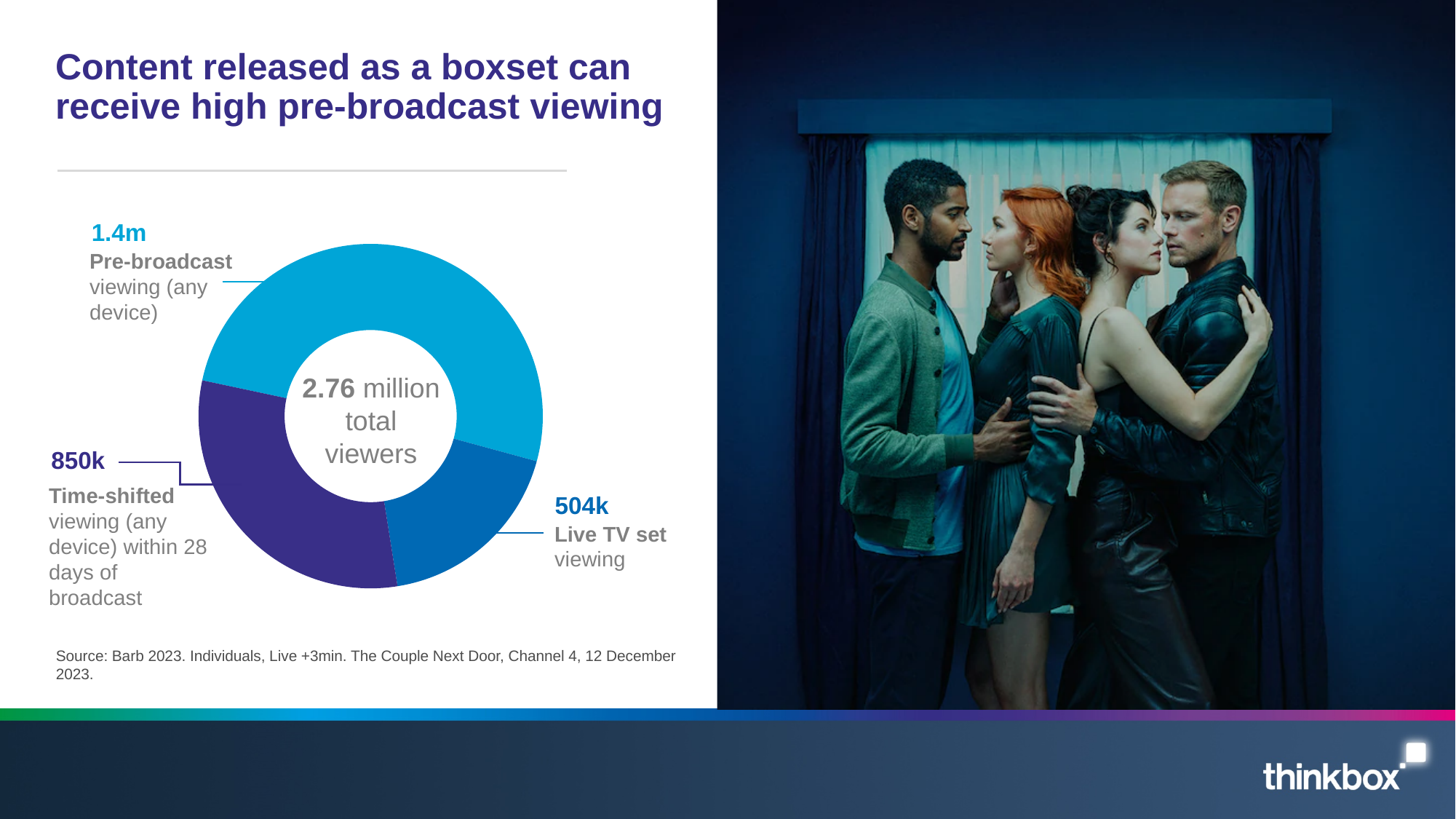
What is the value for Time-shifted viewing (any device) within 28 days of broadcast? 850k Which is larger, Time-shifted viewing or Live TV set viewing? Time-shifted viewing What kind of chart is shown on the slide? Donut chart What is the value for Live TV set viewing? 504k What is the value for Pre-broadcast viewing (any device)? 1.4m What is the total number of viewers shown in the centre of the chart? 2.76 million Which viewing category has the largest segment of the chart? Pre-broadcast viewing (any device) What colour is the Time-shifted viewing segment of the chart? Purple Which viewing category has the smallest segment of the chart? Live TV set viewing What is the title of the slide containing the chart? Content released as a boxset can receive high pre-broadcast viewing What is the difference between Time-shifted viewing (850k) and Live TV set viewing (504k)? 346k How many viewing categories are shown in the chart? 3